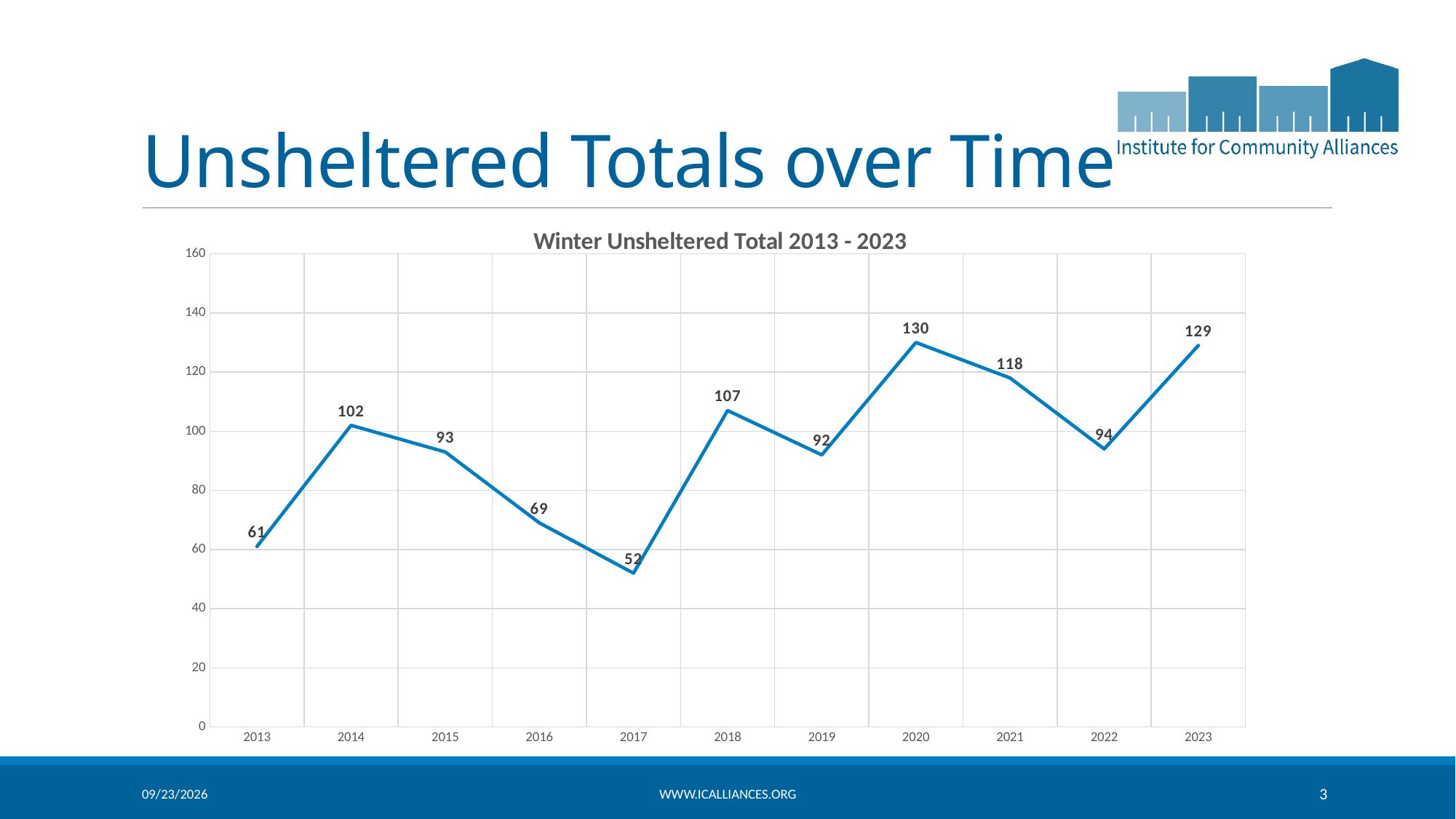
Which year has the lowest winter unsheltered total? 2017 What kind of chart is shown on the slide? Line chart What is the winter unsheltered total for 2013? 61 Which year has the highest winter unsheltered total? 2020 How many years are plotted on the chart? 11 What is the winter unsheltered total for 2017? 52 Is the value for 2021 greater or less than 100? greater What is the title of the chart? Winter Unsheltered Total 2013 - 2023 Which year has a larger winter unsheltered total, 2018 or 2019? 2018 Did the winter unsheltered total rise or fall from 2014 to 2017? Fall What is the winter unsheltered total for 2020? 130 What is the difference between the winter unsheltered totals for 2023 and 2022? 35